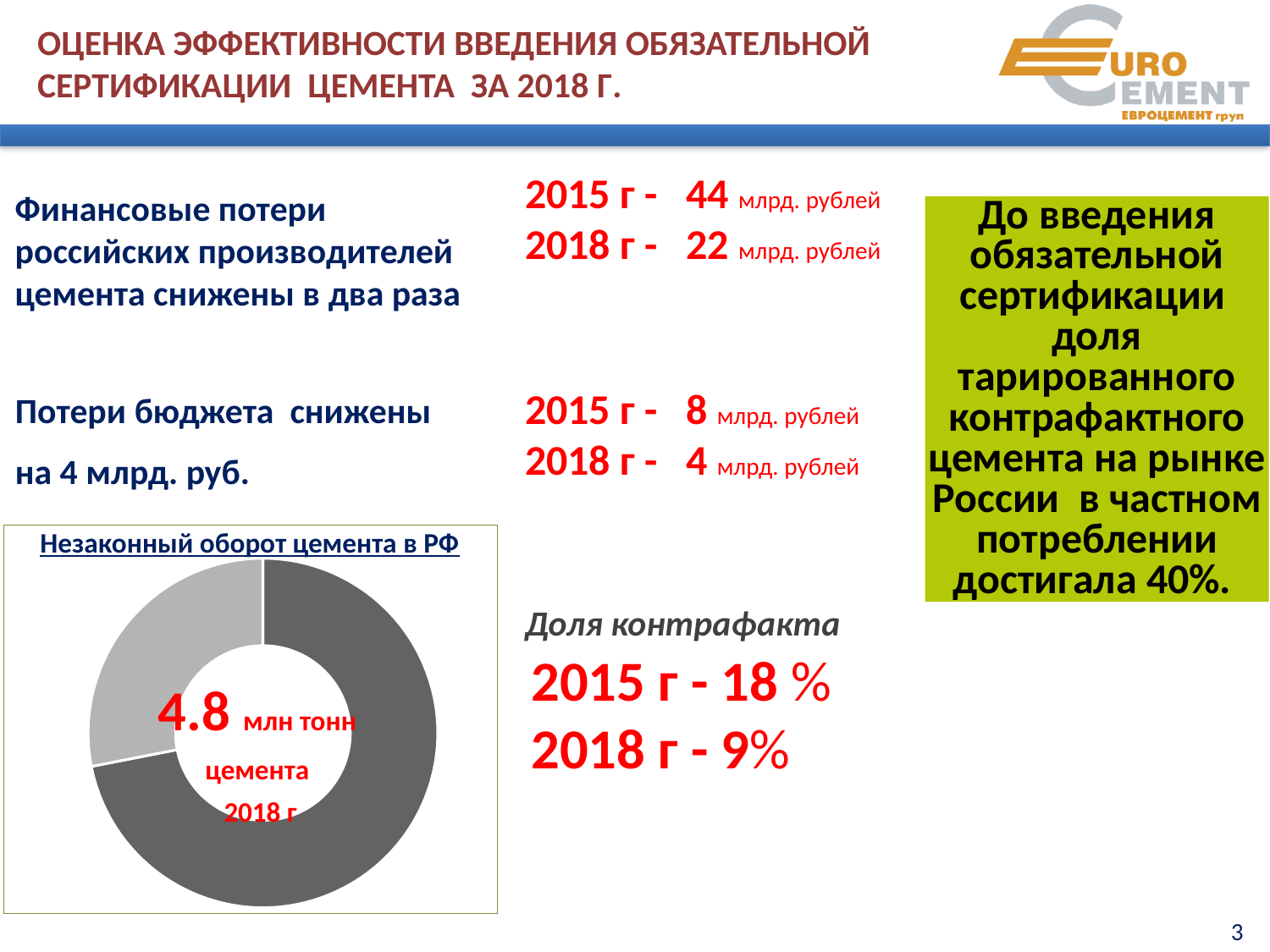
What is the title of the chart on the slide? Незаконный оборот цемента в РФ What value is printed in the centre of the doughnut chart? 4.8 млн тонн цемента What kind of chart is shown on the slide under the heading "Незаконный оборот цемента в РФ"? Doughnut (pie) chart How many slices does the doughnut chart "Незаконный оборот цемента в РФ" have? 2 Which year does the doughnut chart "Незаконный оборот цемента в РФ" refer to, according to its centre label? 2018 г Does the largest slice of the doughnut chart take up more or less than half of the ring? more Does the doughnut chart "Незаконный оборот цемента в РФ" show a legend? No